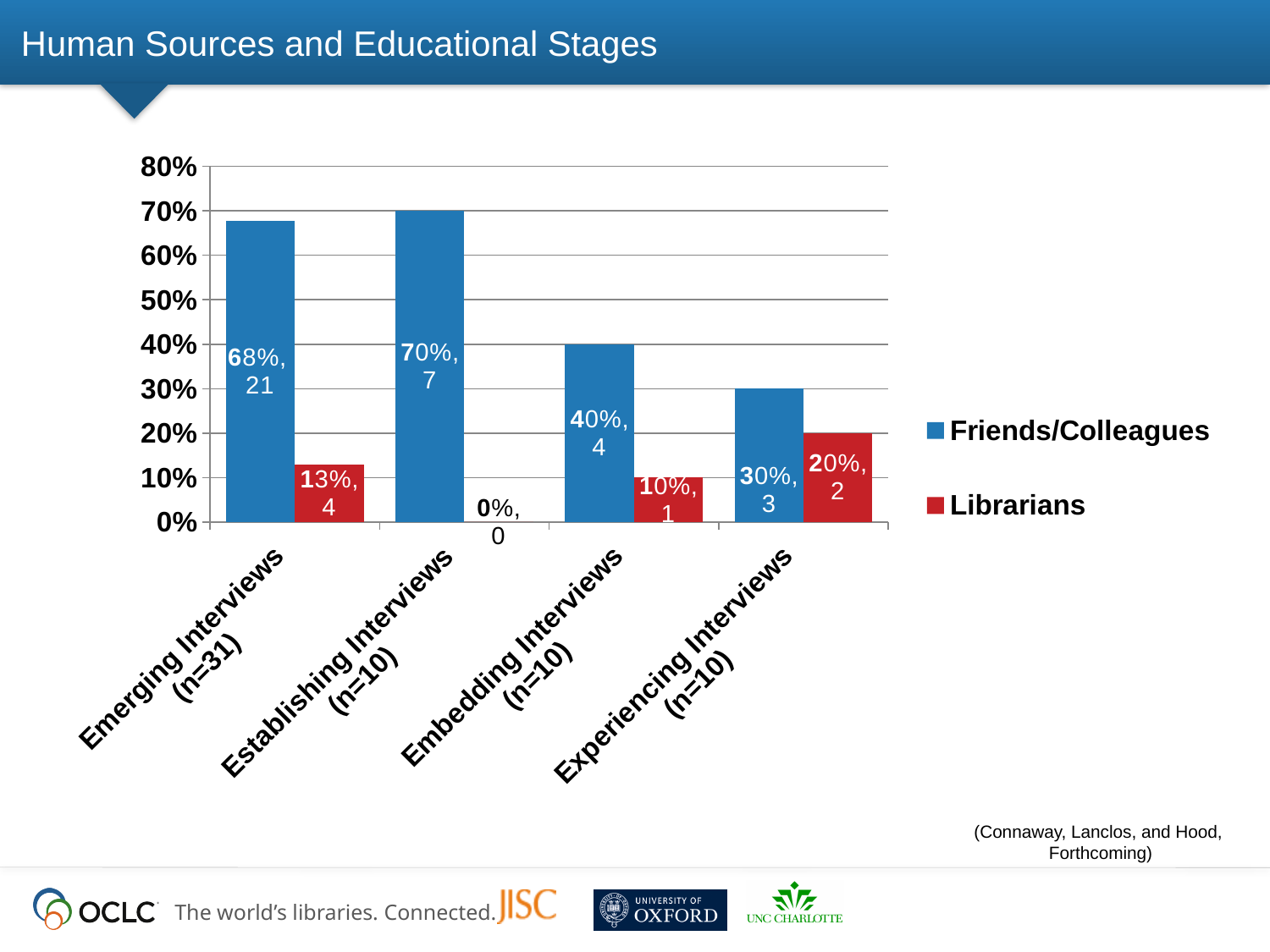
Which educational stage has the highest Friends/Colleagues value? Establishing Interviews (n=10) What is the Friends/Colleagues value for Emerging Interviews (n=31)? 68% What is the Librarians value for Establishing Interviews (n=10)? 0% How many series does the legend list? 2 What kind of chart is shown on the slide? Bar chart Which educational stage has the lowest Librarians value? Establishing Interviews (n=10) How many educational stages are shown on the x axis? 4 What is the title of the slide containing the chart? Human Sources and Educational Stages What is the difference between the Friends/Colleagues and Librarians values for Embedding Interviews (n=10)? 30% Is the Friends/Colleagues value for Embedding Interviews (n=10) greater or less than 50%? less Which is larger for Experiencing Interviews (n=10): the Friends/Colleagues value or the Librarians value? Friends/Colleagues What is the Librarians value for Experiencing Interviews (n=10)? 20%